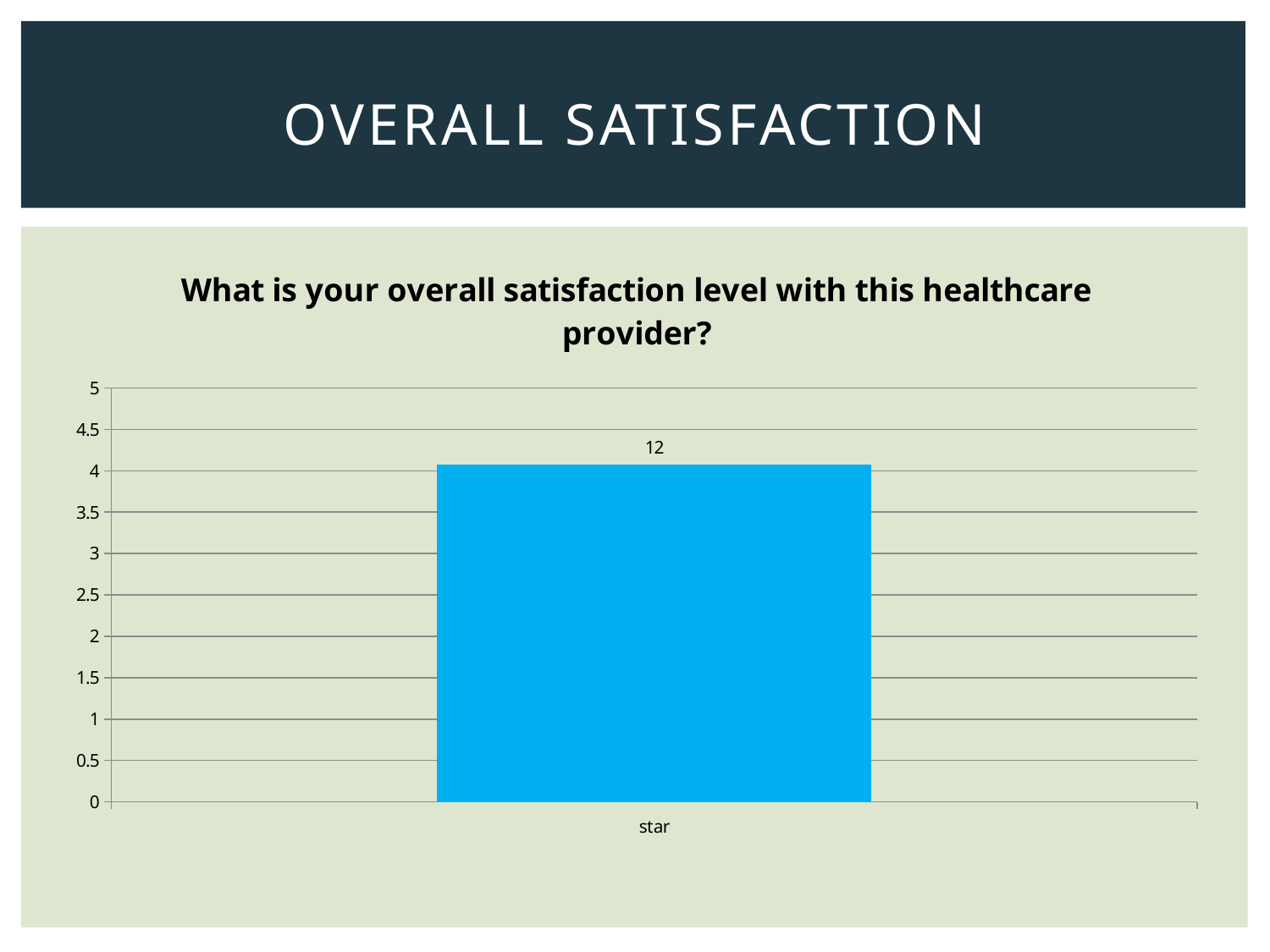
What data label is printed above the bar for star? 12 What kind of chart is shown on the slide? bar chart Is the height of the bar for star greater or less than 3 on the y axis? greater What is the highest value shown on the y axis of the chart? 5 What is the category label shown on the x axis of the chart? star What is the chart's title? What is your overall satisfaction level with this healthcare provider? What colour is the bar in the chart? blue How many bars are plotted in the chart? 1 Is the height of the bar for star greater or less than 2 on the y axis? greater Is the height of the bar for star greater or less than 4.5 on the y axis? less